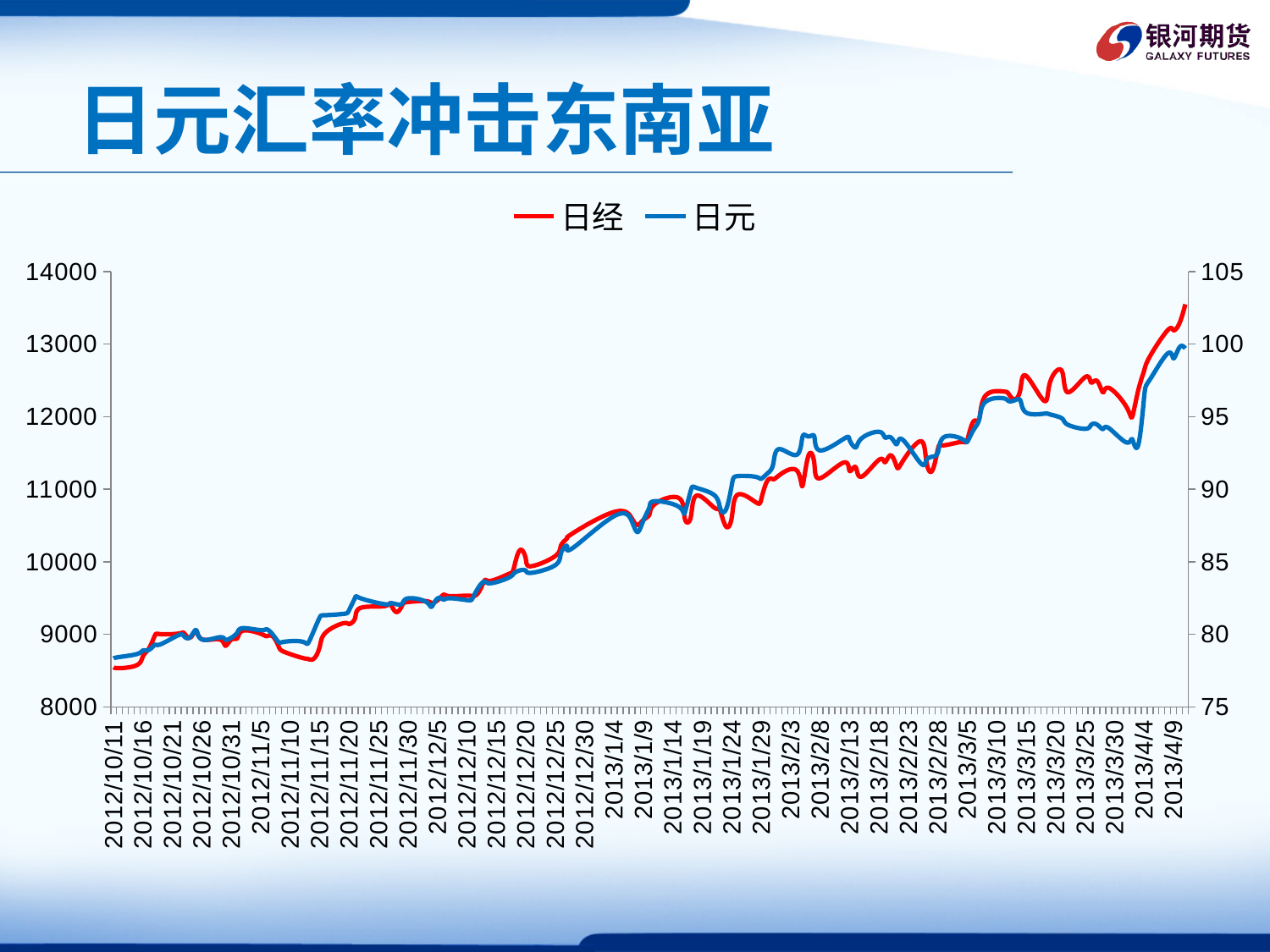
Is the value for 日元 at 2013/4/9 (right axis) greater or less than 95? greater Is the value for 日经 at 2013/1/4 greater or less than 10000? greater Is the value for 日经 at 2013/4/9 greater or less than 13000? greater What is the title of the slide chart? 日元汇率冲击东南亚 Do the values of the 日经 series generally rise or fall from 2012/10/11 to 2013/4/9? rise What kind of chart is shown on the slide? line chart Do the values of the 日元 series generally rise or fall across the x axis? rise How many series does the legend list? 2 Which series is drawn in red? 日经